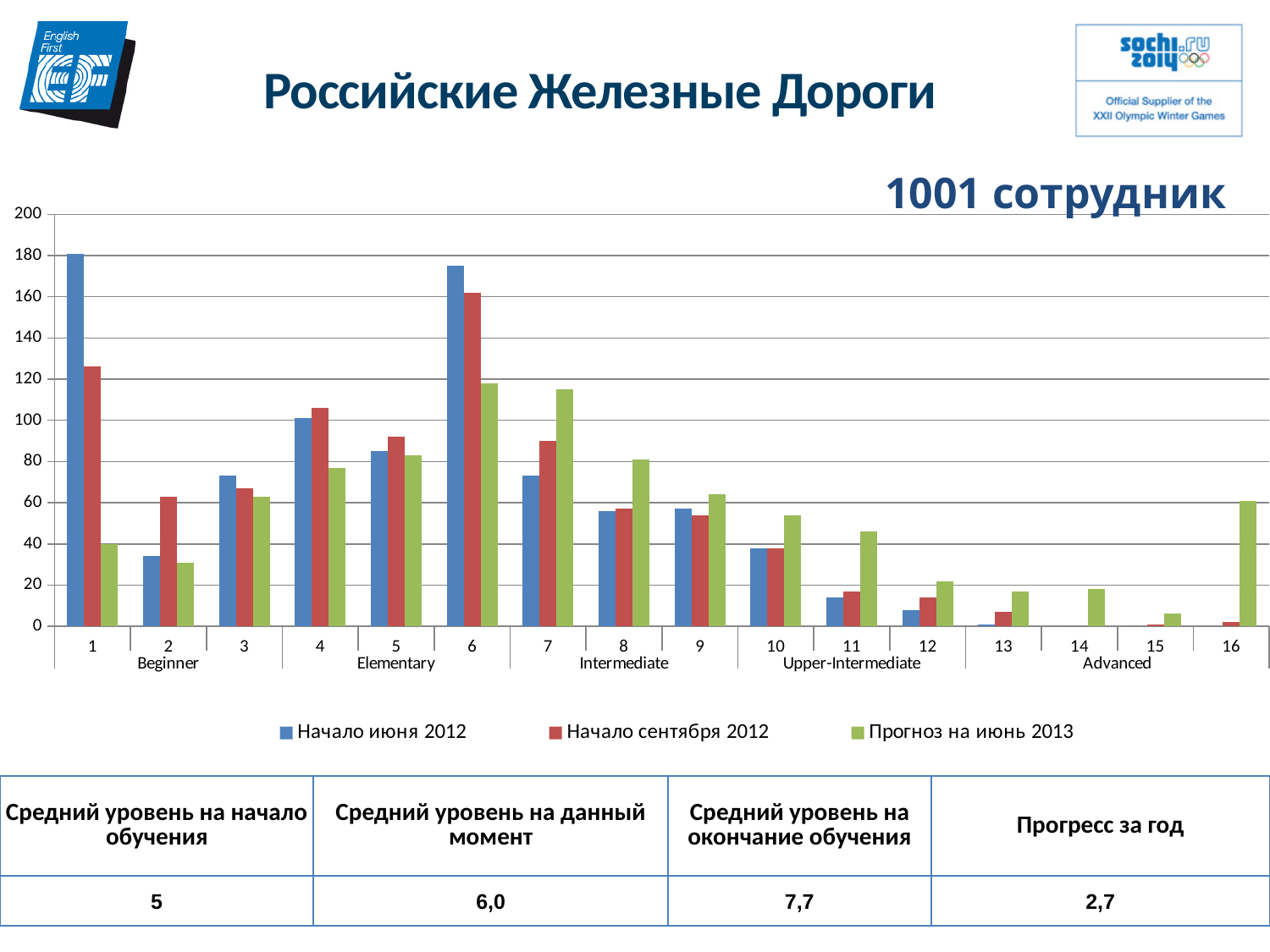
Is the value for level 6 in the series "Начало сентября 2012" greater or less than 140? greater Which level has the highest value for the series "Начало июня 2012"? 1 At level 1, which series has the larger value: "Начало июня 2012" or "Начало сентября 2012"? Начало июня 2012 How many series does the chart legend list? 3 Which level has the highest value for the series "Прогноз на июнь 2013"? 6 Is the value for level 1 in the series "Начало июня 2012" greater or less than 160? greater What kind of chart is shown on the slide? bar chart At level 7, which series has the larger value: "Начало июня 2012" or "Прогноз на июнь 2013"? Прогноз на июнь 2013 Is the value for level 16 in the series "Прогноз на июнь 2013" greater or less than 40? greater How many numbered levels are shown along the x axis of the chart? 16 What are the three series listed in the chart legend? Начало июня 2012, Начало сентября 2012, Прогноз на июнь 2013 What heading appears above the chart on the right? 1001 сотрудник